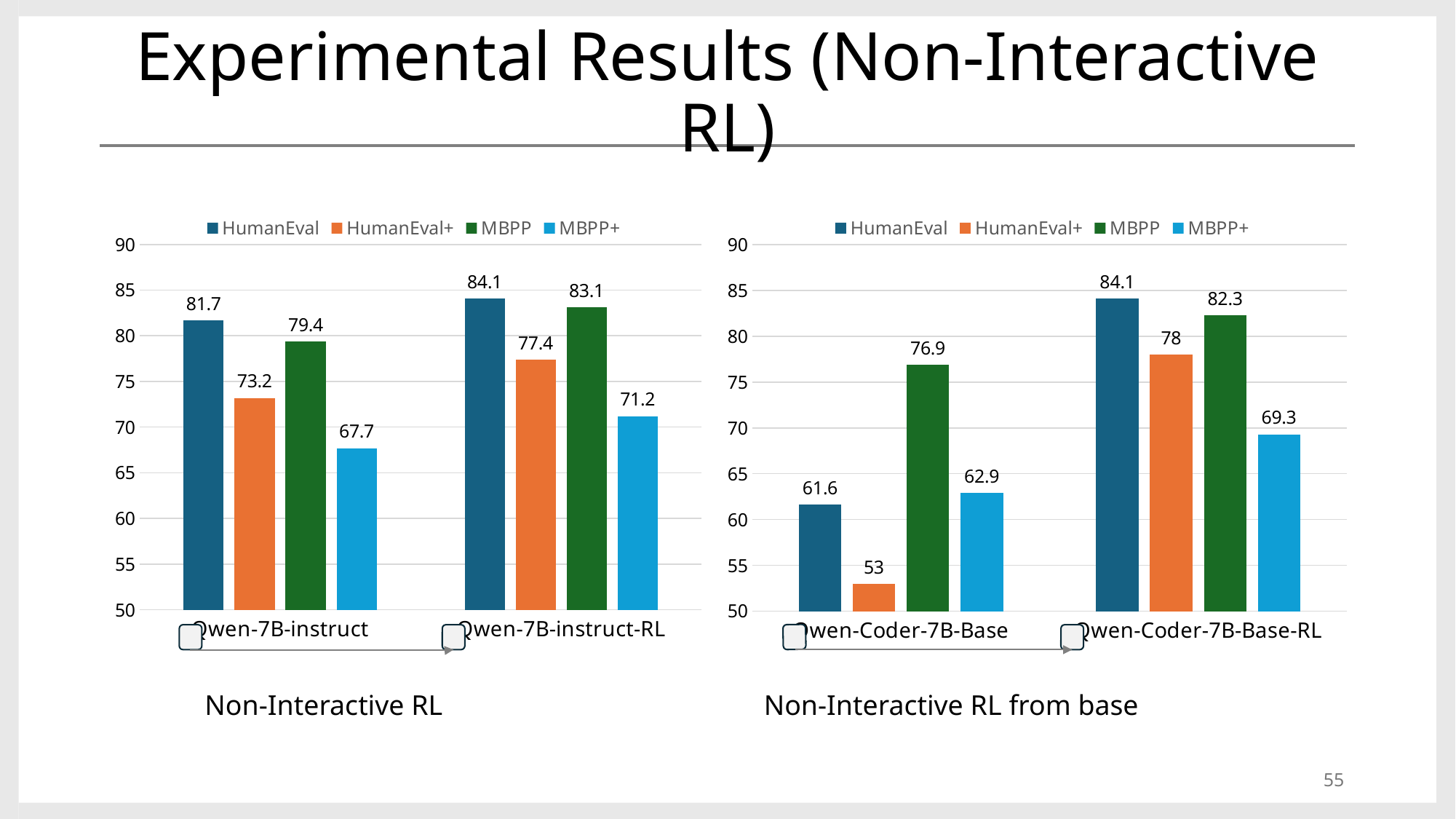
In the left chart (Non-Interactive RL), what is the difference between the HumanEval+ values for Qwen-7B-instruct-RL and Qwen-7B-instruct? 4.2 In the right chart (Non-Interactive RL from base), what is the HumanEval+ value for Qwen-Coder-7B-Base? 53 In the right chart (Non-Interactive RL from base), what is the MBPP value for Qwen-Coder-7B-Base-RL? 82.3 What kind of chart is the left chart (Non-Interactive RL)? Bar chart In the left chart (Non-Interactive RL), what is the MBPP+ value for Qwen-7B-instruct-RL? 71.2 In the left chart (Non-Interactive RL), which series has the lowest value for Qwen-7B-instruct? MBPP+ How many series does the legend of the left chart (Non-Interactive RL) list? 4 In the right chart (Non-Interactive RL from base), what is the difference between the HumanEval values for Qwen-Coder-7B-Base-RL and Qwen-Coder-7B-Base? 22.5 In the left chart (Non-Interactive RL), what is the HumanEval value for Qwen-7B-instruct? 81.7 In the right chart (Non-Interactive RL from base), which is larger: the MBPP value for Qwen-Coder-7B-Base or the MBPP+ value for Qwen-Coder-7B-Base-RL? MBPP value for Qwen-Coder-7B-Base In the right chart (Non-Interactive RL from base), which series has the highest value for Qwen-Coder-7B-Base-RL? HumanEval How many categories are shown on the x axis of the right chart (Non-Interactive RL from base)? 2